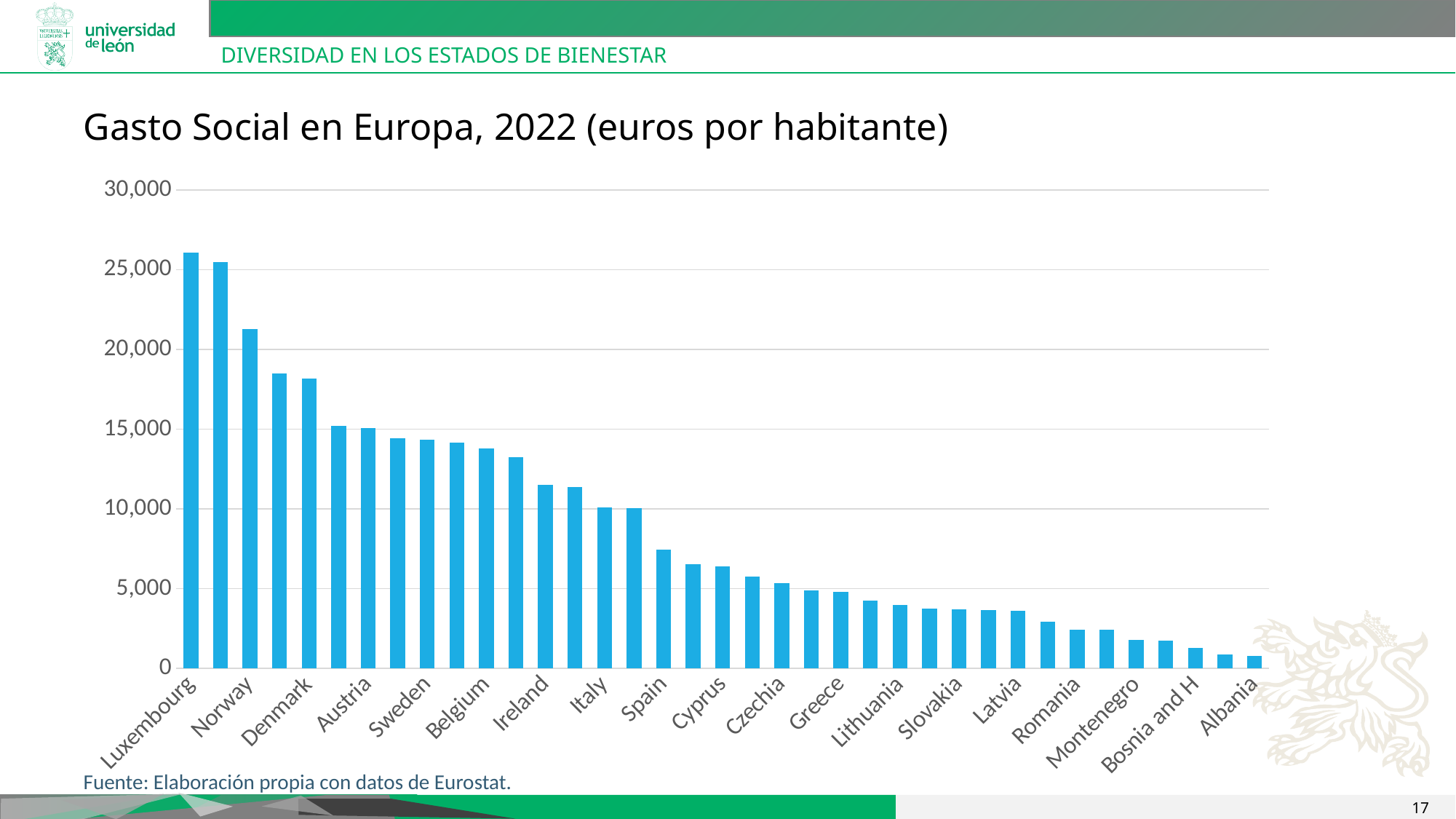
Which country has the lowest social spending per inhabitant in the chart? Albania What is the title of the chart? Gasto Social en Europa, 2022 (euros por habitante) Is the value for Sweden greater or less than 15,000? less Is the value for Denmark greater or less than 20,000? less Is the value for Romania greater or less than 5,000? less Which country has the highest social spending per inhabitant in the chart? Luxembourg What kind of chart is shown on the slide? bar chart Do the values rise or fall from left to right along the x axis? fall Which has a larger value, Denmark or Austria? Denmark